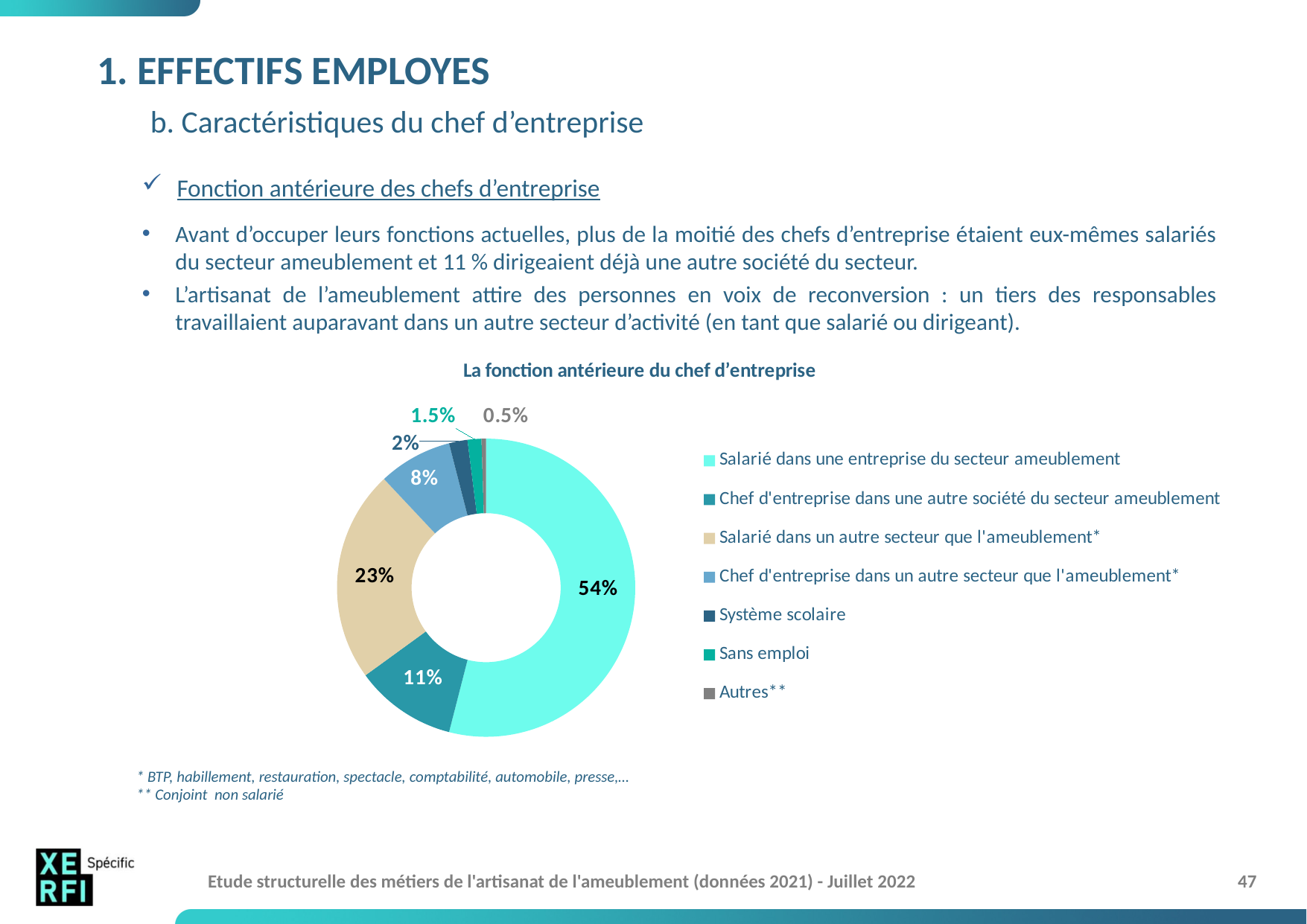
Which category has the smallest share in the chart? Autres** What type of chart is shown on the slide? Donut (pie) chart What is the difference between the shares of 'Salarié dans une entreprise du secteur ameublement' and 'Salarié dans un autre secteur que l'ameublement*'? 31% What share of the chart 'La fonction antérieure du chef d'entreprise' is 'Salarié dans une entreprise du secteur ameublement'? 54% What is the value for 'Sans emploi' in the chart? 1.5% What share does 'Salarié dans un autre secteur que l'ameublement*' represent in the chart? 23% What is the title of the chart on the slide? La fonction antérieure du chef d'entreprise What is the value for 'Système scolaire' in the chart? 2% What is the value for 'Chef d'entreprise dans une autre société du secteur ameublement' in the chart? 11% Which is larger: the share for 'Chef d'entreprise dans une autre société du secteur ameublement' or the share for 'Chef d'entreprise dans un autre secteur que l'ameublement*'? Chef d'entreprise dans une autre société du secteur ameublement How many categories are shown in the chart? 7 Which category has the largest share in the chart? Salarié dans une entreprise du secteur ameublement